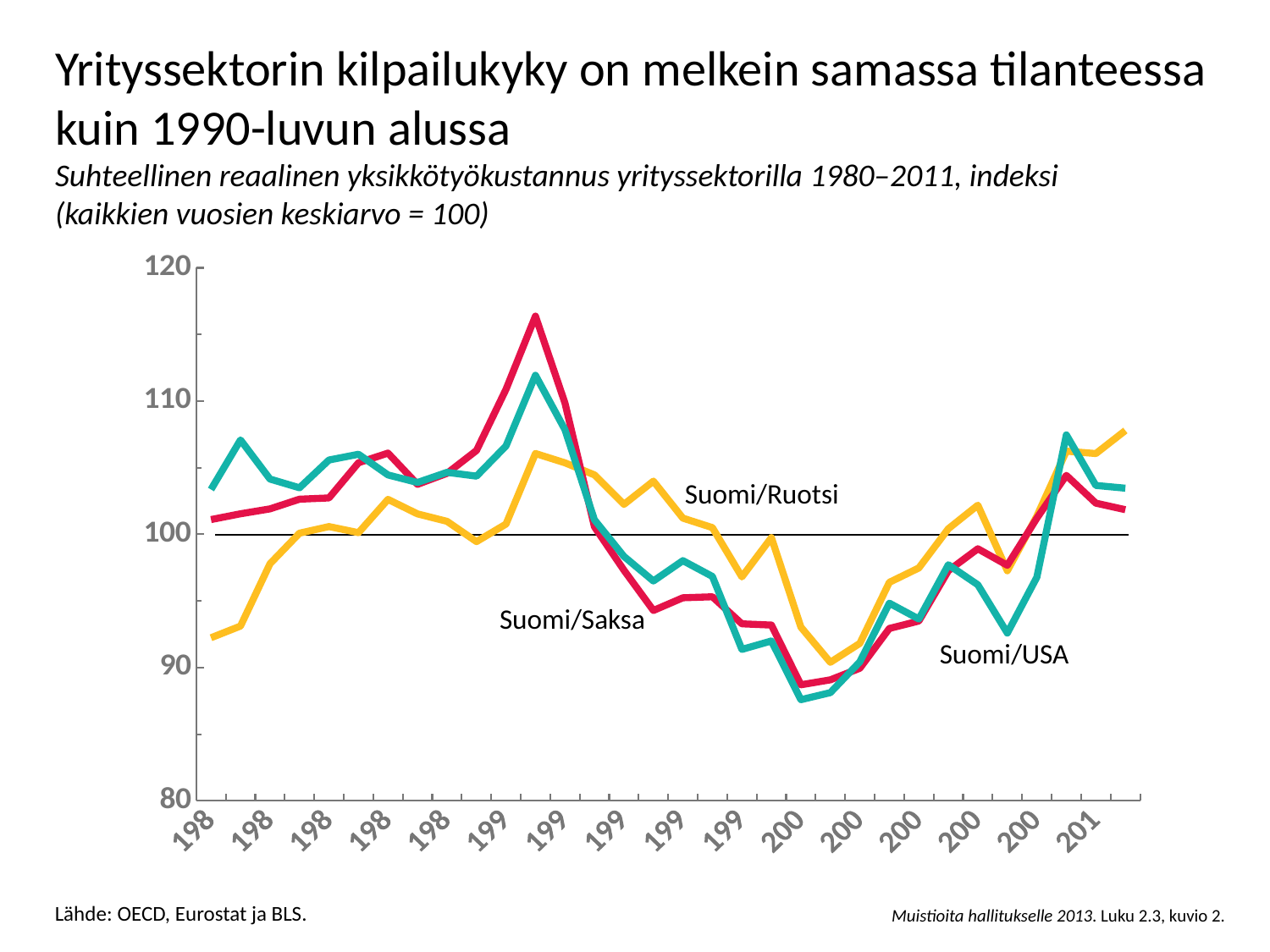
Is the lowest point of the Suomi/USA series greater or less than 90? less Which series falls to the lowest point on the chart? Suomi/USA What kind of chart is shown on the slide? Line chart Which series reaches the highest peak on the chart? Suomi/Saksa What value does the horizontal reference line on the chart mark? 100 How many series are plotted on the chart? 3 Is the highest peak of the Suomi/Ruotsi series greater or less than 110? less Is the highest peak of the Suomi/Saksa series greater or less than 110? greater Which series has the higher peak, Suomi/Saksa or Suomi/Ruotsi? Suomi/Saksa What is the lowest value shown on the vertical axis? 80